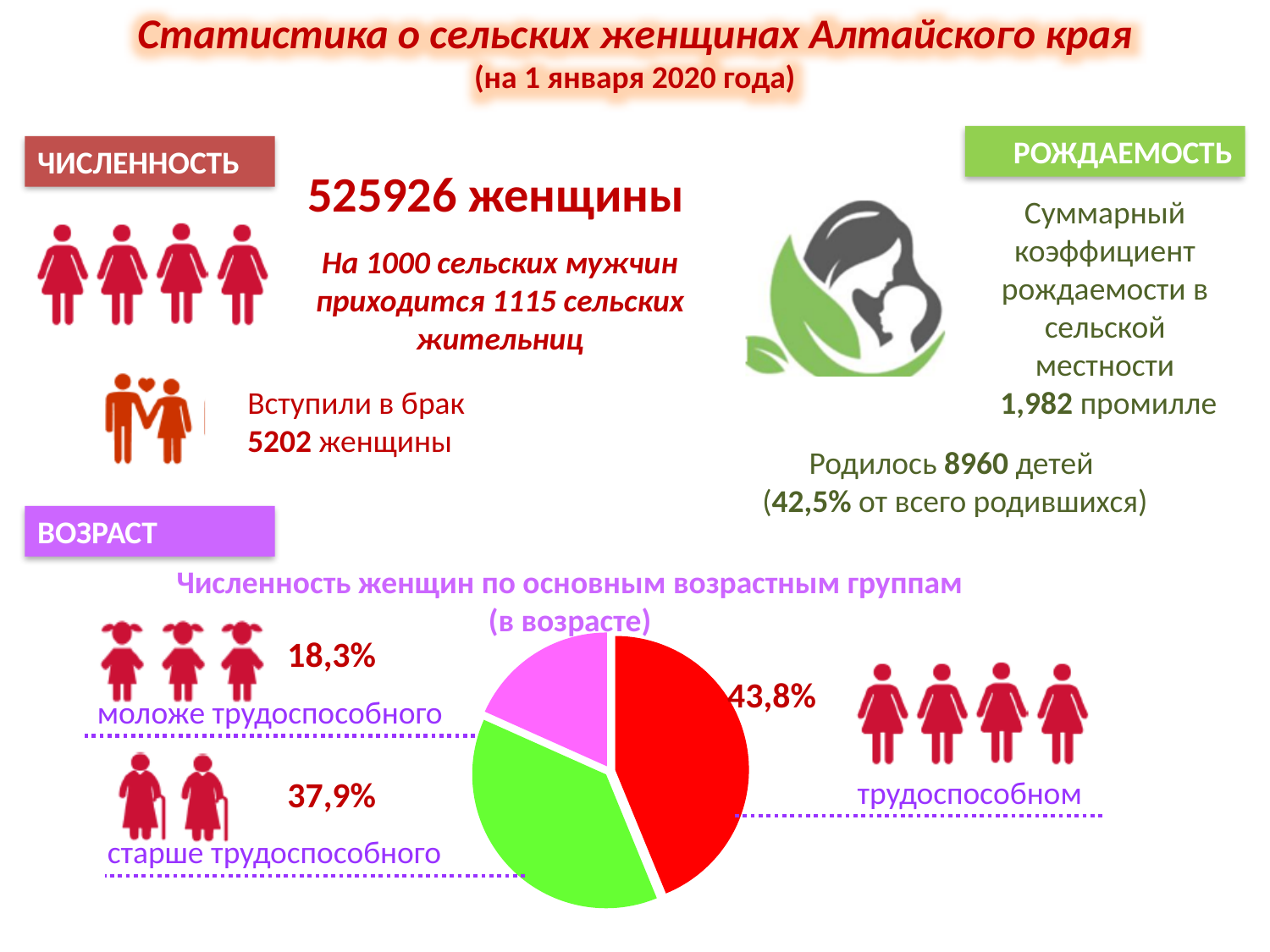
In the pie chart, which is larger: the share for старше трудоспособного or the share for моложе трудоспособного? старше трудоспособного What kind of chart is shown in the ВОЗРАСТ section of the slide? pie chart What share of the pie chart corresponds to women younger than working age (моложе трудоспособного)? 18,3% Which age group has the smallest slice in the pie chart? моложе трудоспособного What is the difference in percentage points between the старше трудоспособного slice and the моложе трудоспособного slice? 19,6 What colour is the slice representing women of working age (трудоспособном) in the pie chart? red How many slices does the pie chart have? 3 What is the difference in percentage points between the трудоспособном slice and the старше трудоспособного slice? 5,9 Which age group has the largest slice in the pie chart? трудоспособном What share of the pie chart corresponds to women of working age (трудоспособном)? 43,8% What is the title of the pie chart? Численность женщин по основным возрастным группам (в возрасте) What share of the pie chart corresponds to women older than working age (старше трудоспособного)? 37,9%